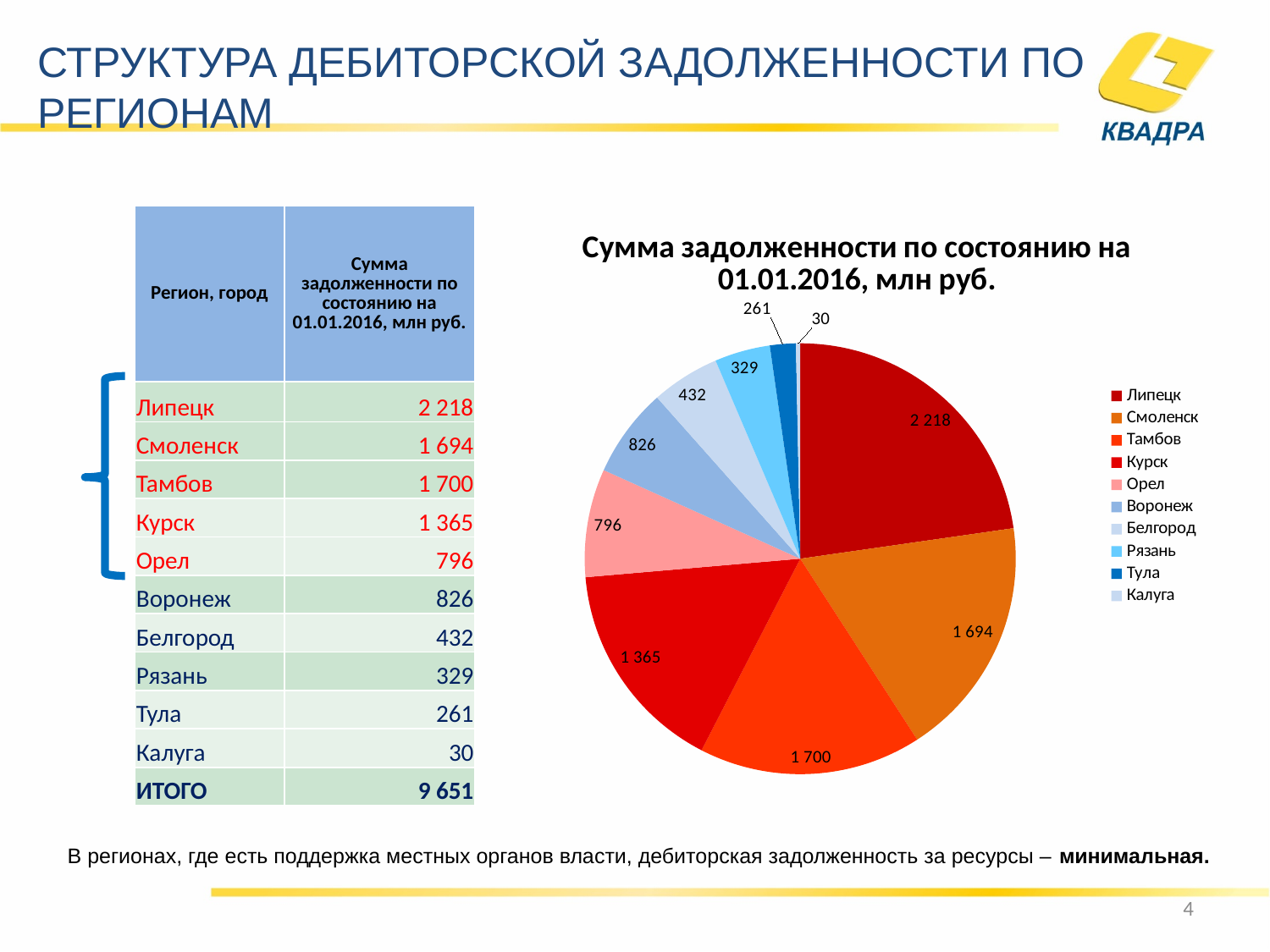
What is the value for Курск in the pie chart? 1 365 What is the title of the pie chart? Сумма задолженности по состоянию на 01.01.2016, млн руб. What is the value for Калуга in the pie chart? 30 Which is larger, the value for Рязань or the value for Тула? Рязань How many regions (slices) are shown in the pie chart? 10 Which region has the largest slice in the pie chart? Липецк Which region has the smallest slice in the pie chart? Калуга What is the difference between the values for Воронеж and Орел? 30 What kind of chart is shown on the slide? pie chart What is the value for Липецк in the pie chart? 2 218 What is the value for Белгород in the pie chart? 432 What is the difference between the values for Липецк and Курск? 853